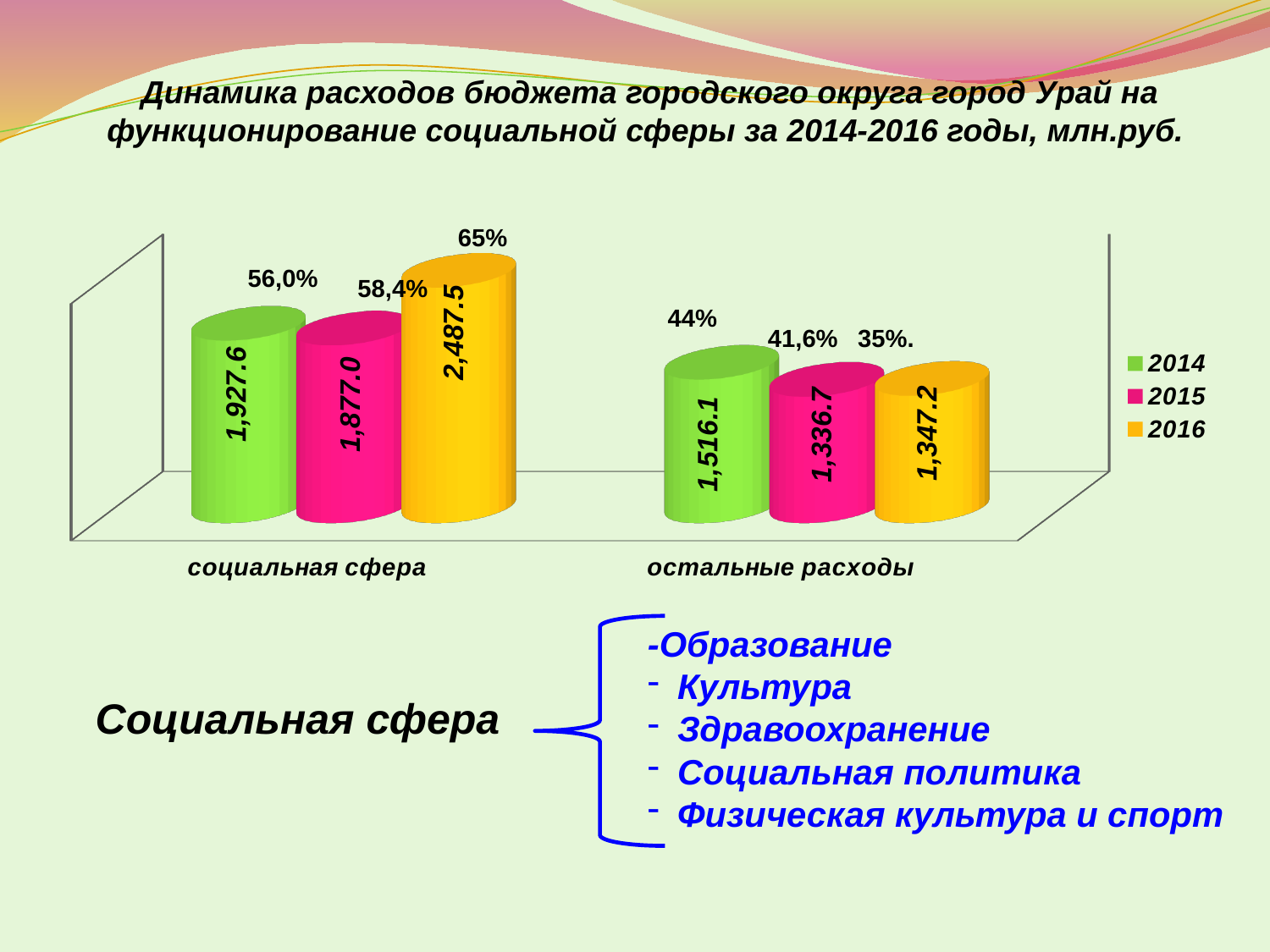
How many series does the legend list? 3 What is the value for 2014 in the "социальная сфера" category? 1,927.6 What is the value for 2016 in the "социальная сфера" category? 2,487.5 How many categories are shown on the x axis? 2 What is the difference between the 2016 and 2014 values in the "социальная сфера" category? 559.9 What percentage label is shown above the 2016 bar in the "остальные расходы" category? 35% Which year has the lowest value in the "остальные расходы" category? 2015 What kind of chart is shown on the slide? bar chart Which colour represents the 2015 series in the legend? pink Which year has the highest value in the "социальная сфера" category? 2016 What is the value for 2015 in the "остальные расходы" category? 1,336.7 Which is larger: the 2014 value for "социальная сфера" or the 2014 value for "остальные расходы"? социальная сфера